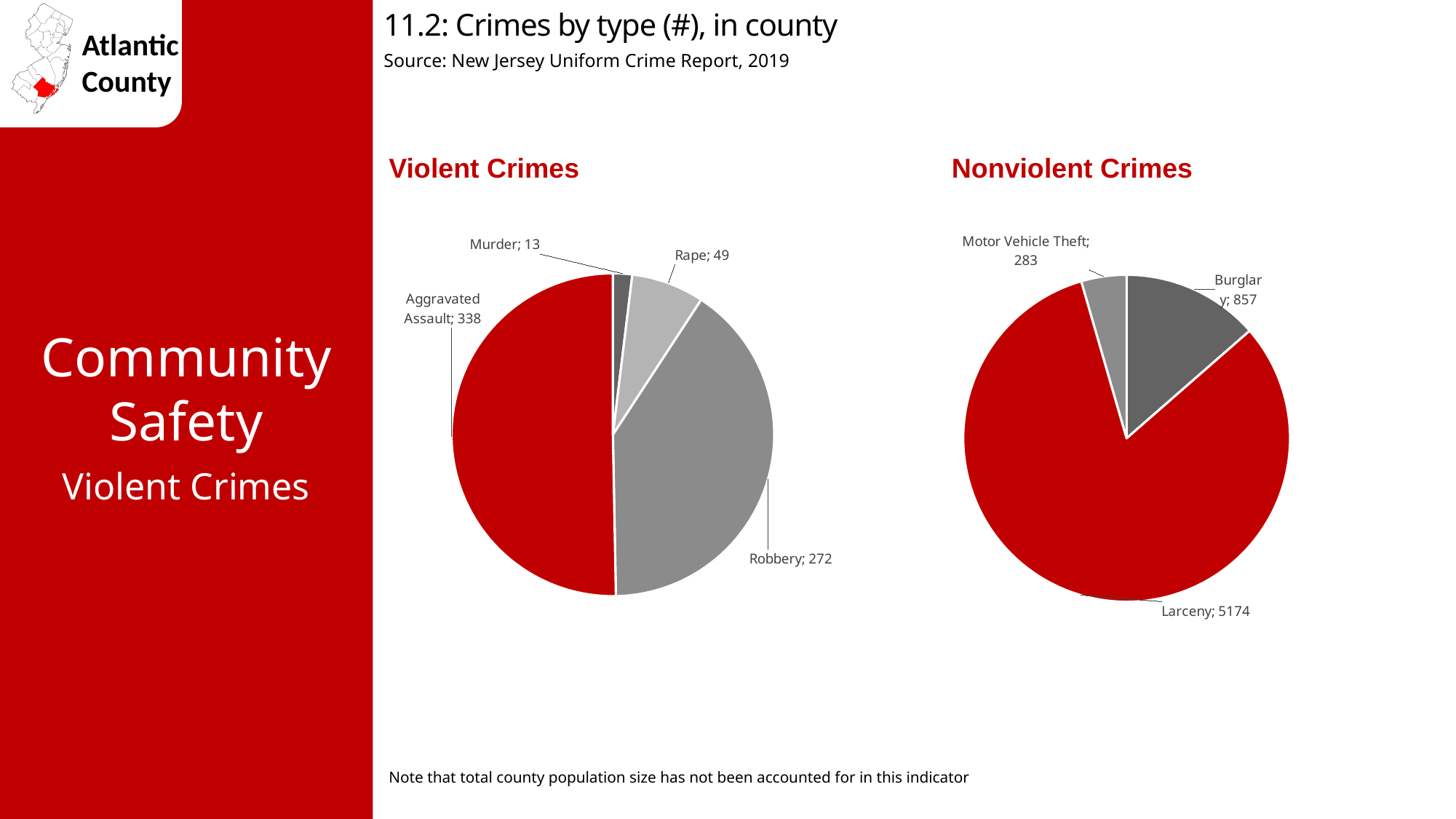
In the Nonviolent Crimes chart, which crime type has the largest slice? Larceny In the Nonviolent Crimes chart, what is the value for Motor Vehicle Theft? 283 In the Nonviolent Crimes chart, what is the value for Burglary? 857 In the Nonviolent Crimes chart, what is the difference between Larceny and Burglary? 4317 In the Violent Crimes chart, which crime type has the largest slice? Aggravated Assault What type of chart is used for Nonviolent Crimes? Pie chart In the Violent Crimes chart, which crime type has the smallest slice? Murder In the Violent Crimes chart, what is the value for Murder? 13 How many crime types are shown in the Violent Crimes chart? 4 In the Violent Crimes chart, what is the difference between Aggravated Assault and Robbery? 66 In the Nonviolent Crimes chart, which is larger, Burglary or Motor Vehicle Theft? Burglary In the Violent Crimes chart, how many robberies are shown? 272